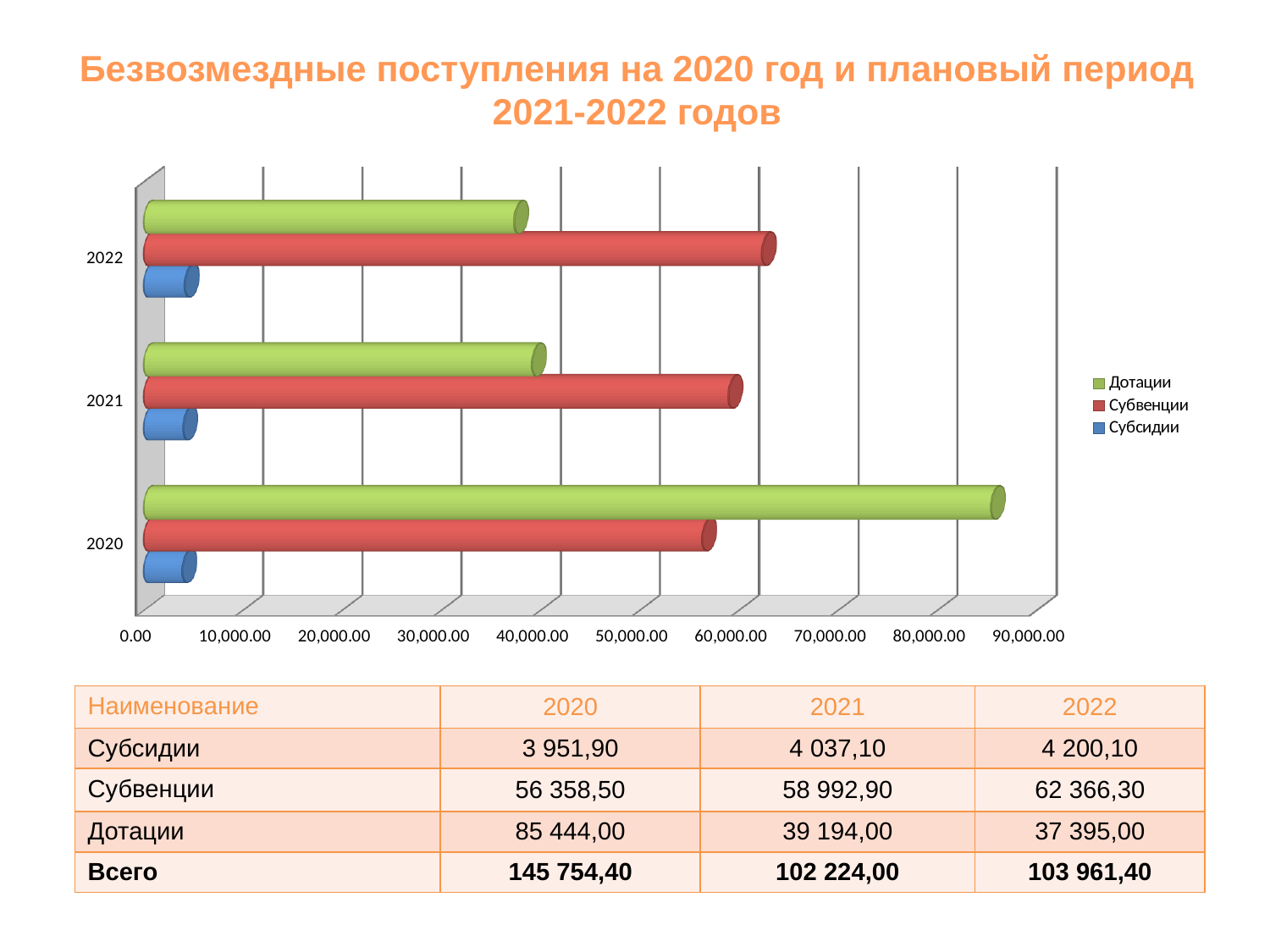
What type of chart is shown on the slide? bar chart Is the value of Дотации for 2020 greater or less than 80,000.00? greater Which series has the lowest value in 2022? Субсидии What is the value of Субсидии for 2021? 4 037,10 What is the difference between Субвенции in 2022 and Субвенции in 2020? 6 007,80 Which is larger in 2021: Субвенции or Дотации? Субвенции What is the value of Дотации for 2020? 85 444,00 How many series does the chart legend list? 3 How many year categories are shown on the chart's vertical axis? 3 In which year is the Дотации value the highest? 2020 Does the Дотации value rise or fall from 2020 to 2022? fall What is the value of Субвенции for 2022? 62 366,30